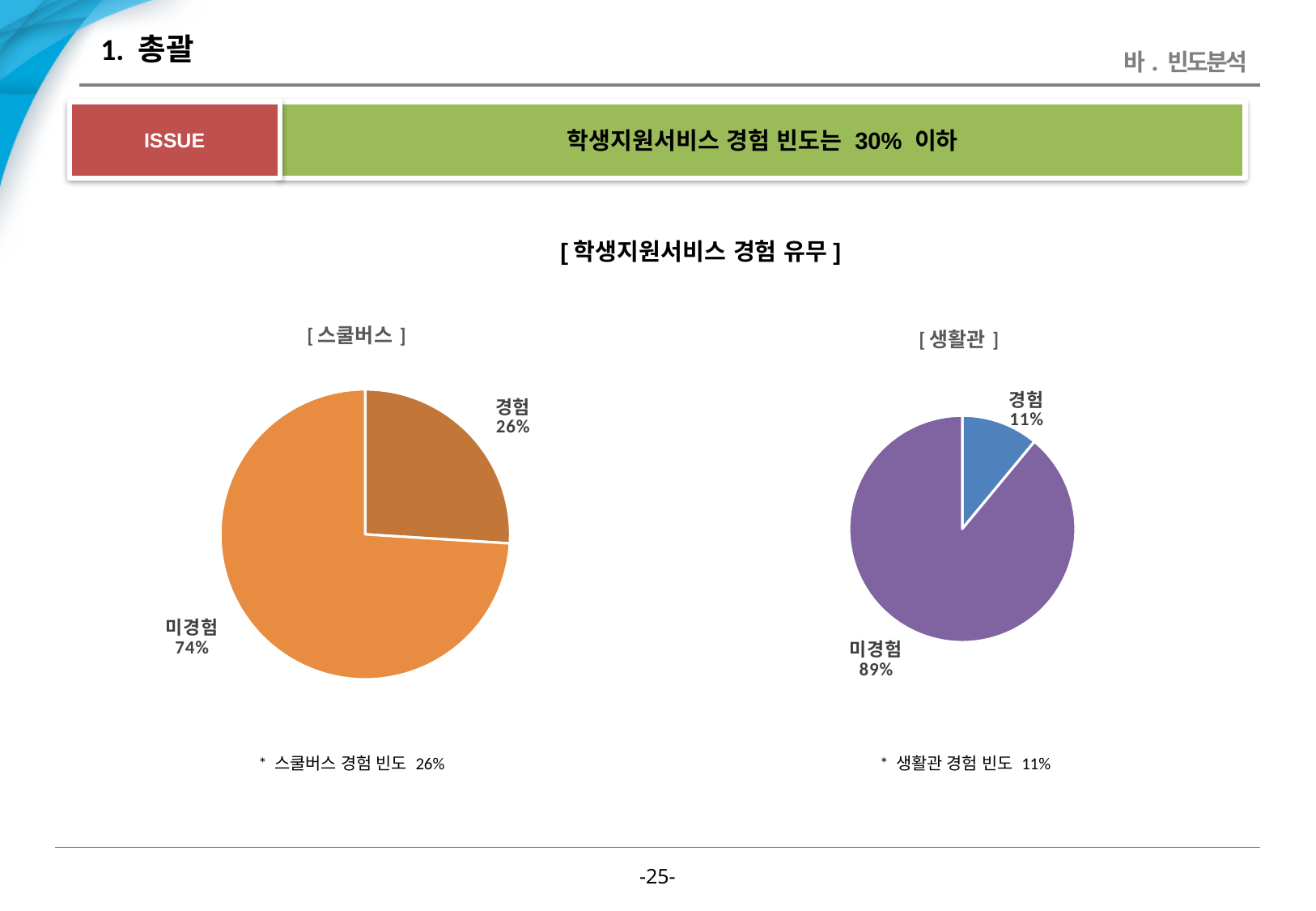
In the [ 생활관 ] pie chart, what is the difference between 미경험 and 경험? 78% What kind of chart is the [ 스쿨버스 ] chart? Pie chart In the [ 생활관 ] pie chart, what is the value for 경험? 11% In the [ 생활관 ] pie chart, which category has the smallest slice? 경험 In the [ 스쿨버스 ] pie chart, what is the value for 미경험? 74% In the [ 스쿨버스 ] pie chart, what is the difference between 미경험 and 경험? 48% What is the overall title shown above the two pie charts? [ 학생지원서비스 경험 유무 ] How many slices does the [ 생활관 ] pie chart have? 2 In the [ 스쿨버스 ] pie chart, what is the value for 경험? 26% In the [ 스쿨버스 ] pie chart, which category has the largest slice? 미경험 Which is larger: the 경험 value in the [ 스쿨버스 ] chart or the 경험 value in the [ 생활관 ] chart? [ 스쿨버스 ] 경험 In the [ 생활관 ] pie chart, what is the value for 미경험? 89%